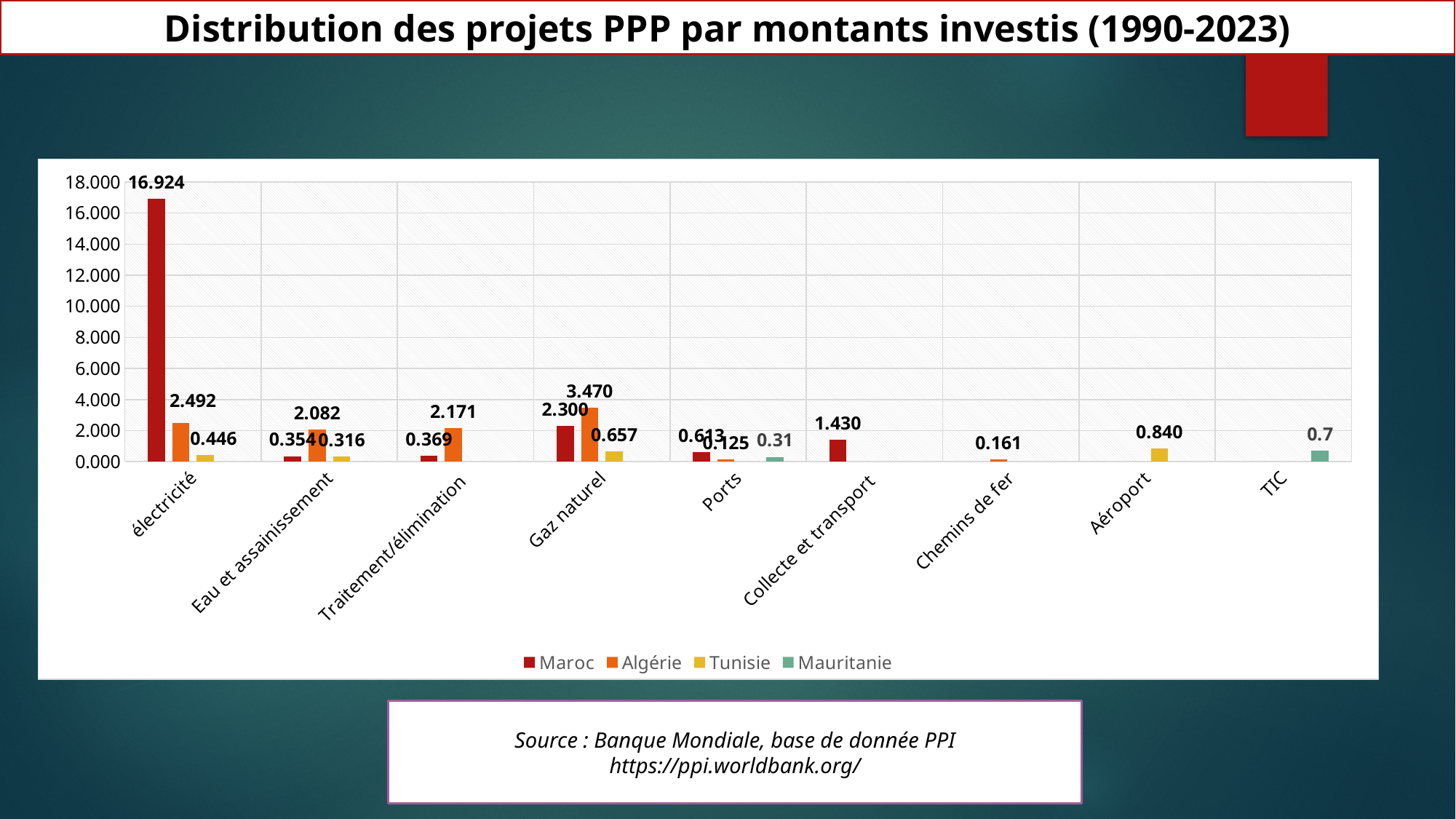
Which category has the highest value for Maroc? électricité What type of chart is shown on the slide? bar chart How many categories are shown on the x axis? 9 Which category has the lowest value for Algérie? Ports In the Eau et assainissement category, which is larger: the value for Maroc or the value for Algérie? Algérie How many series does the legend list? 4 What is the value for Maroc in the électricité category? 16.924 What is the title of the chart? Distribution des projets PPP par montants investis (1990-2023) What is the value for Mauritanie in the TIC category? 0.7 What is the value for Tunisie in the Aéroport category? 0.840 What is the value for Algérie in the Gaz naturel category? 3.470 What is the difference between the Algérie and Maroc values in the Gaz naturel category? 1.170